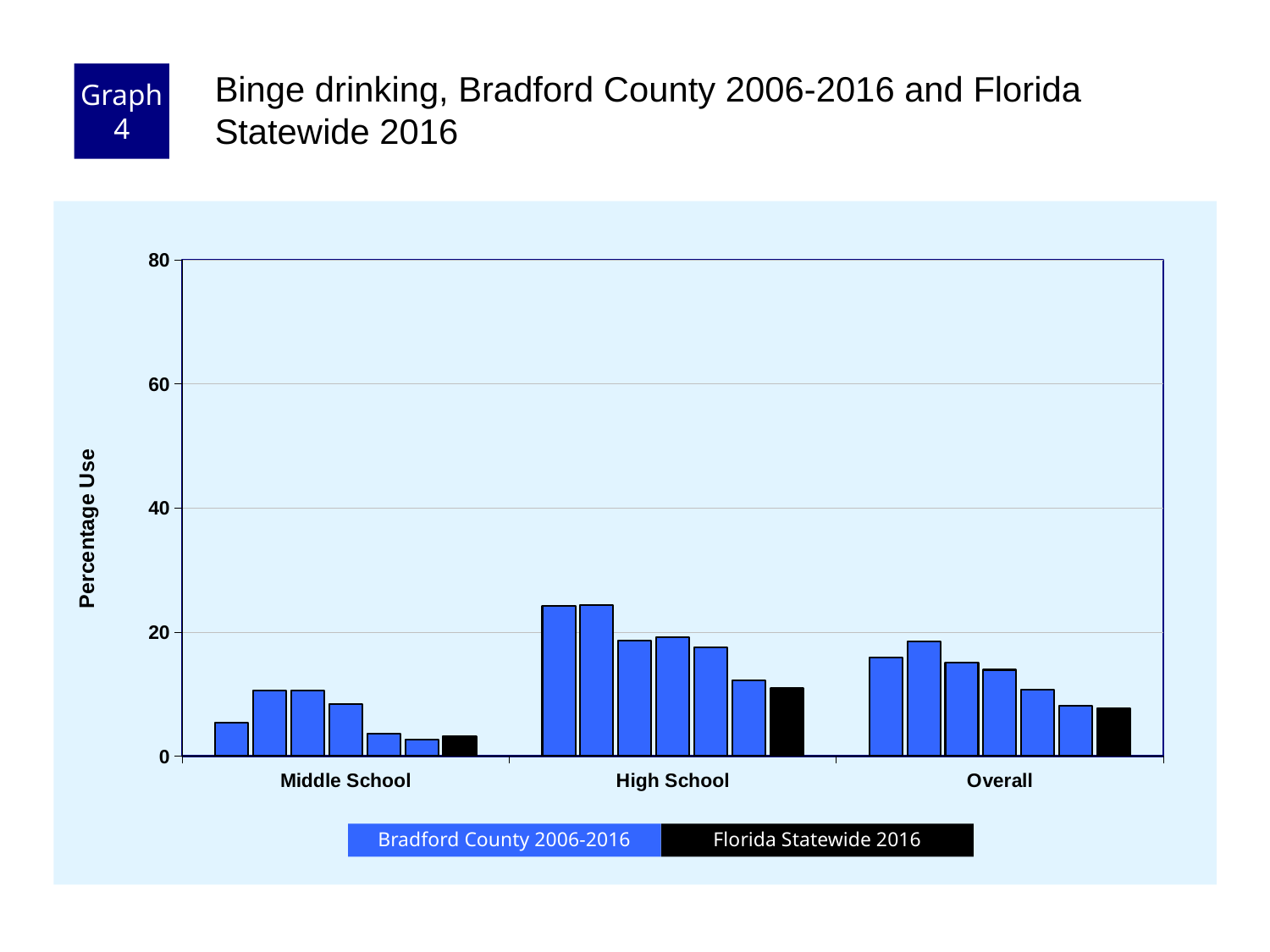
Is the tallest Bradford County 2006-2016 bar for High School greater or less than 20? greater Which is larger, the Florida Statewide 2016 value for High School or for Middle School? High School What kind of chart is shown on the slide? bar chart Which colour represents Florida Statewide 2016 in the legend? black Which category has the lowest Florida Statewide 2016 value? Middle School How many categories are shown on the x axis? 3 Is the Florida Statewide 2016 value for High School greater or less than 20? less How many series does the legend list? 2 Within the High School group, do the Bradford County 2006-2016 bars generally rise or fall from left to right? fall Which category has the highest Florida Statewide 2016 value? High School Is the Florida Statewide 2016 value for Overall greater or less than 20? less What is the label on the y axis? Percentage Use